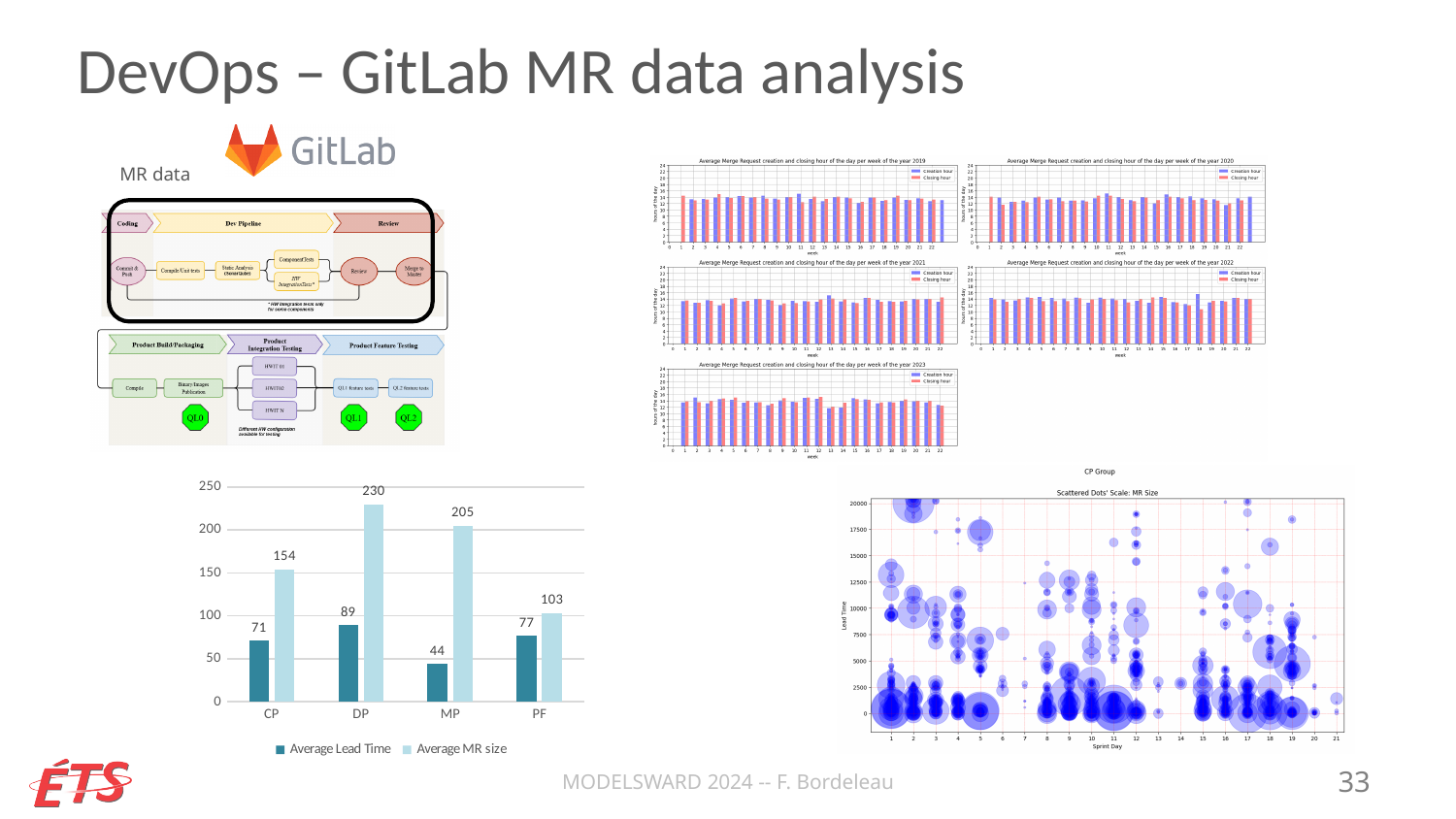
In the bar chart at the bottom left of the slide, what is the Average Lead Time for CP? 71 In the bar chart at the bottom left of the slide, which category has the highest Average MR size? DP In the bar chart at the bottom left of the slide, what is the difference between the Average MR size and the Average Lead Time for MP? 161 What kind of chart is the 'CP Group' chart at the bottom right of the slide? Scatter (bubble) chart What kind of chart is the chart at the bottom left of the slide? Bar chart What is the x-axis label of the 'CP Group' scatter chart at the bottom right of the slide? Sprint Day In the bar chart at the bottom left of the slide, what is the Average MR size for PF? 103 In the bar chart at the bottom left of the slide, how many series does the legend list? 2 In the bar chart at the bottom left of the slide, which is larger: the Average Lead Time for DP or the Average Lead Time for PF? DP In the bar chart at the bottom left of the slide, how many categories are shown on the x axis? 4 In the bar chart at the bottom left of the slide, which category has the lowest Average Lead Time? MP In the bar chart at the bottom left of the slide, what is the Average MR size for DP? 230